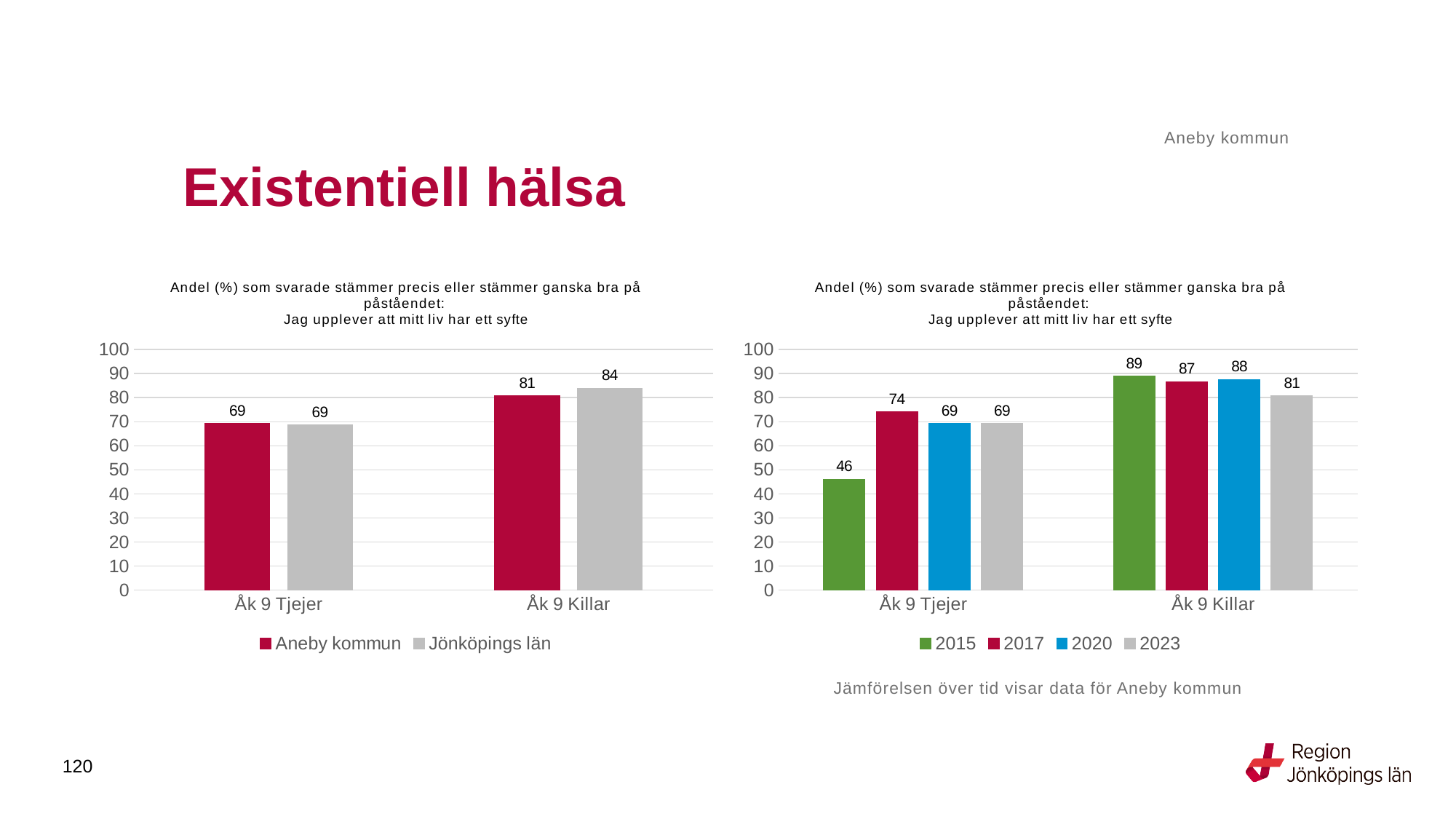
In the left chart, what is the value for Aneby kommun for Åk 9 Killar? 81 In the right chart, what is the value for 2023 for Åk 9 Killar? 81 In the right chart, what is the difference between the 2017 and 2015 values for Åk 9 Tjejer? 28 In the right chart, which year has the lowest value for Åk 9 Tjejer? 2015 In the left chart, what is the difference between Jönköpings län and Aneby kommun for Åk 9 Killar? 3 In the right chart, how many series does the legend list? 4 In the right chart, which is larger for Åk 9 Killar: the 2017 value or the 2023 value? 2017 In the left chart, how many series does the legend list? 2 In the right chart, what is the value for 2015 for Åk 9 Tjejer? 46 In the right chart, which year has the highest value for Åk 9 Killar? 2015 In the left chart, what is the value for Jönköpings län for Åk 9 Killar? 84 In the left chart, what type of chart is shown? Bar chart